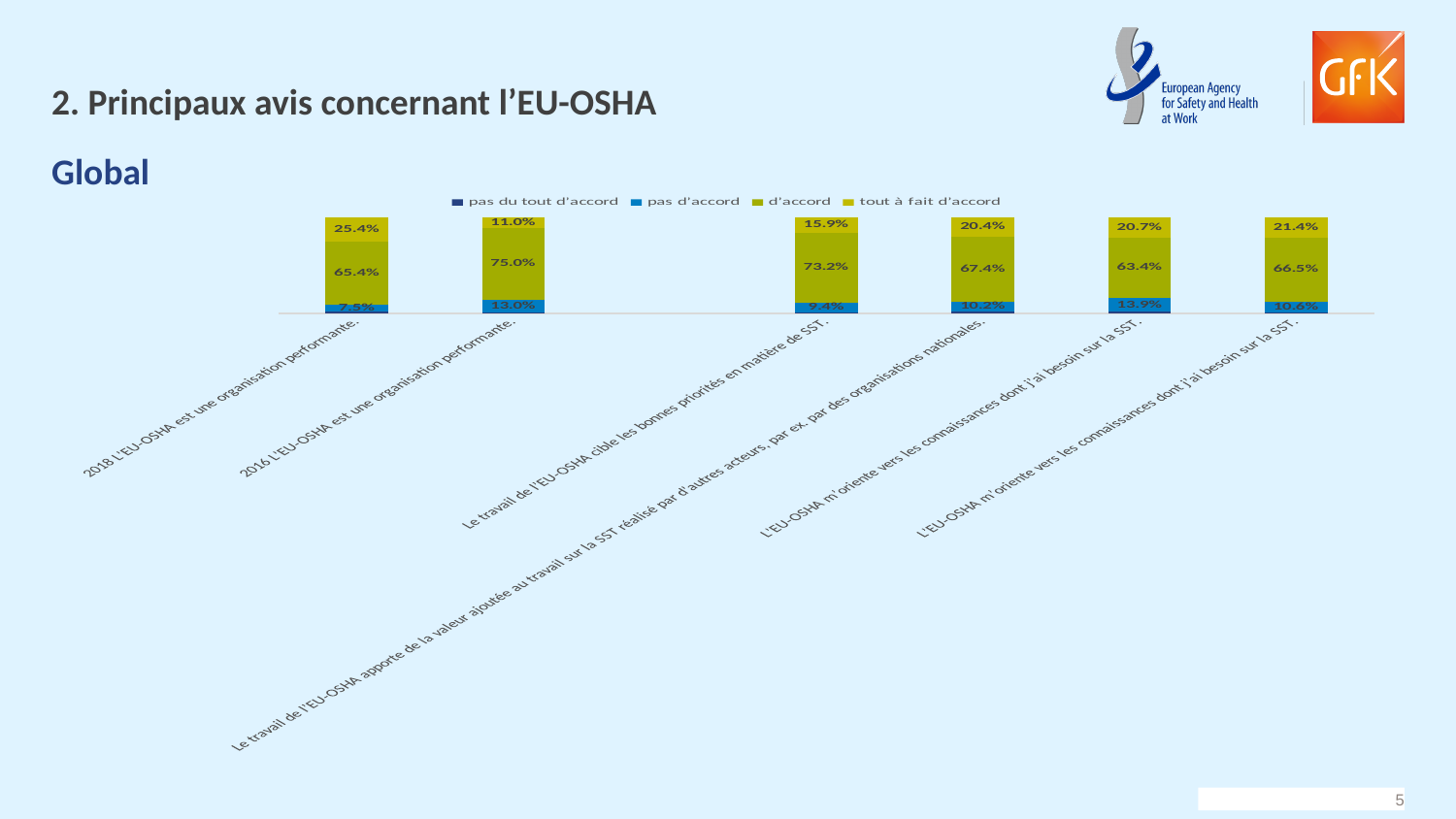
What is the 'tout à fait d'accord' value for '2016 L'EU-OSHA est une organisation performante'? 11.0% How many series does the legend list? 4 How many categories (bars) are shown in the chart? 6 What is the 'pas d'accord' value for 'Le travail de l'EU-OSHA cible les bonnes priorités en matière de SST'? 9.4% Which is larger: the 'pas d'accord' value for '2018 L'EU-OSHA est une organisation performante' or for '2016 L'EU-OSHA est une organisation performante'? 2016 L'EU-OSHA est une organisation performante What is the 'd'accord' value for '2018 L'EU-OSHA est une organisation performante'? 65.4% What type of chart is shown on the slide? stacked bar chart Which category has the lowest 'tout à fait d'accord' value? 2016 L'EU-OSHA est une organisation performante What is the difference between the 'tout à fait d'accord' values for the 2018 and 2016 'L'EU-OSHA est une organisation performante' bars? 14.4% What is the first entry listed in the chart legend? pas du tout d'accord Which category has the highest 'd'accord' value? 2016 L'EU-OSHA est une organisation performante What is the 'd'accord' value for 'Le travail de l'EU-OSHA apporte de la valeur ajoutée au travail sur la SST réalisé par d'autres acteurs, par ex. par des organisations nationales'? 67.4%